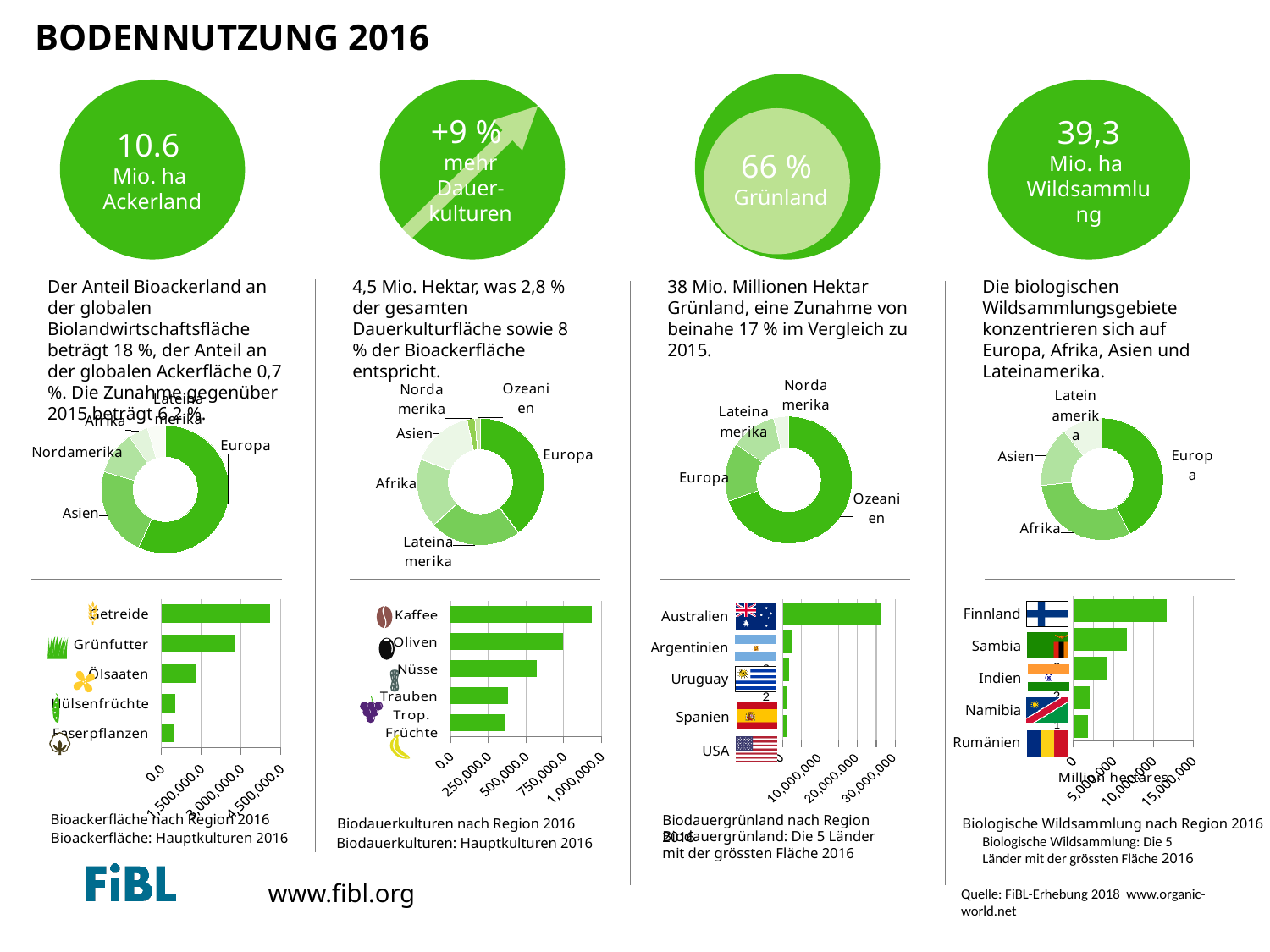
What kind of chart is 'Bioackerfläche nach Region 2016'? Donut (pie) chart In the chart 'Biodauergrünland nach Region 2016', which region has the largest share? Ozeanien In the chart 'Biodauergrünland: Die 5 Länder mit der grössten Fläche 2016', which country has the largest area? Australien In the chart 'Biodauerkulturen: Hauptkulturen 2016', which crop has the largest area? Kaffee In the chart 'Biodauerkulturen: Hauptkulturen 2016', which is larger, Oliven or Nüsse? Oliven In the chart 'Biologische Wildsammlung: Die 5 Länder mit der grössten Fläche 2016', is the value for Finnland greater or less than 10,000,000? greater In the chart 'Bioackerfläche: Hauptkulturen 2016', is the value for Getreide greater or less than 3,000,000.0? greater In the chart 'Biodauergrünland: Die 5 Länder mit der grössten Fläche 2016', is the value for Australien greater or less than 20,000,000? greater How many crops are shown in the chart 'Bioackerfläche: Hauptkulturen 2016'? 5